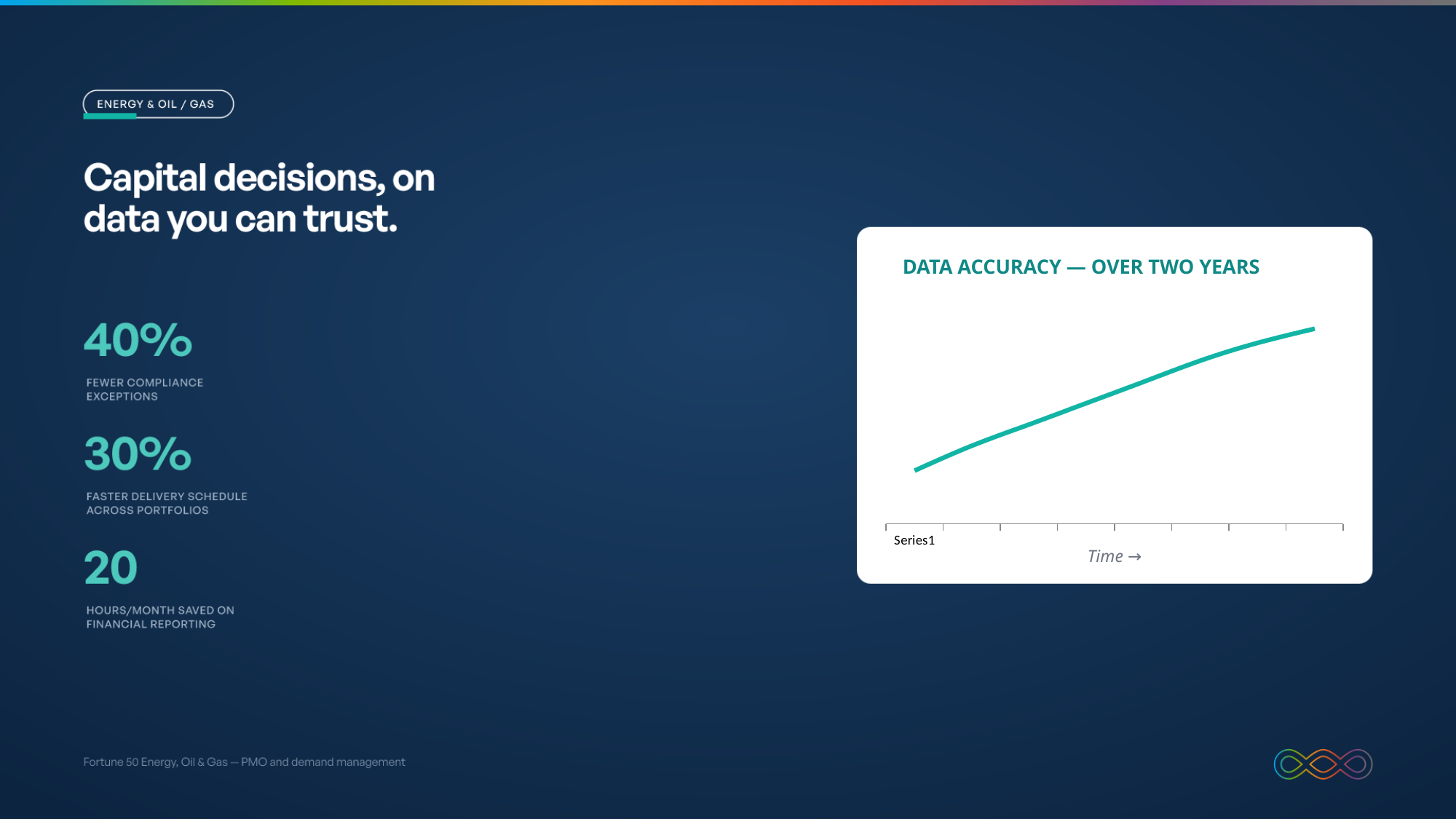
What kind of chart is shown on the slide? line chart Does the line in the "DATA ACCURACY — OVER TWO YEARS" chart rise or fall from left to right? rise What label is shown beneath the horizontal axis of the chart? Time → What is the title of the chart on the slide? DATA ACCURACY — OVER TWO YEARS